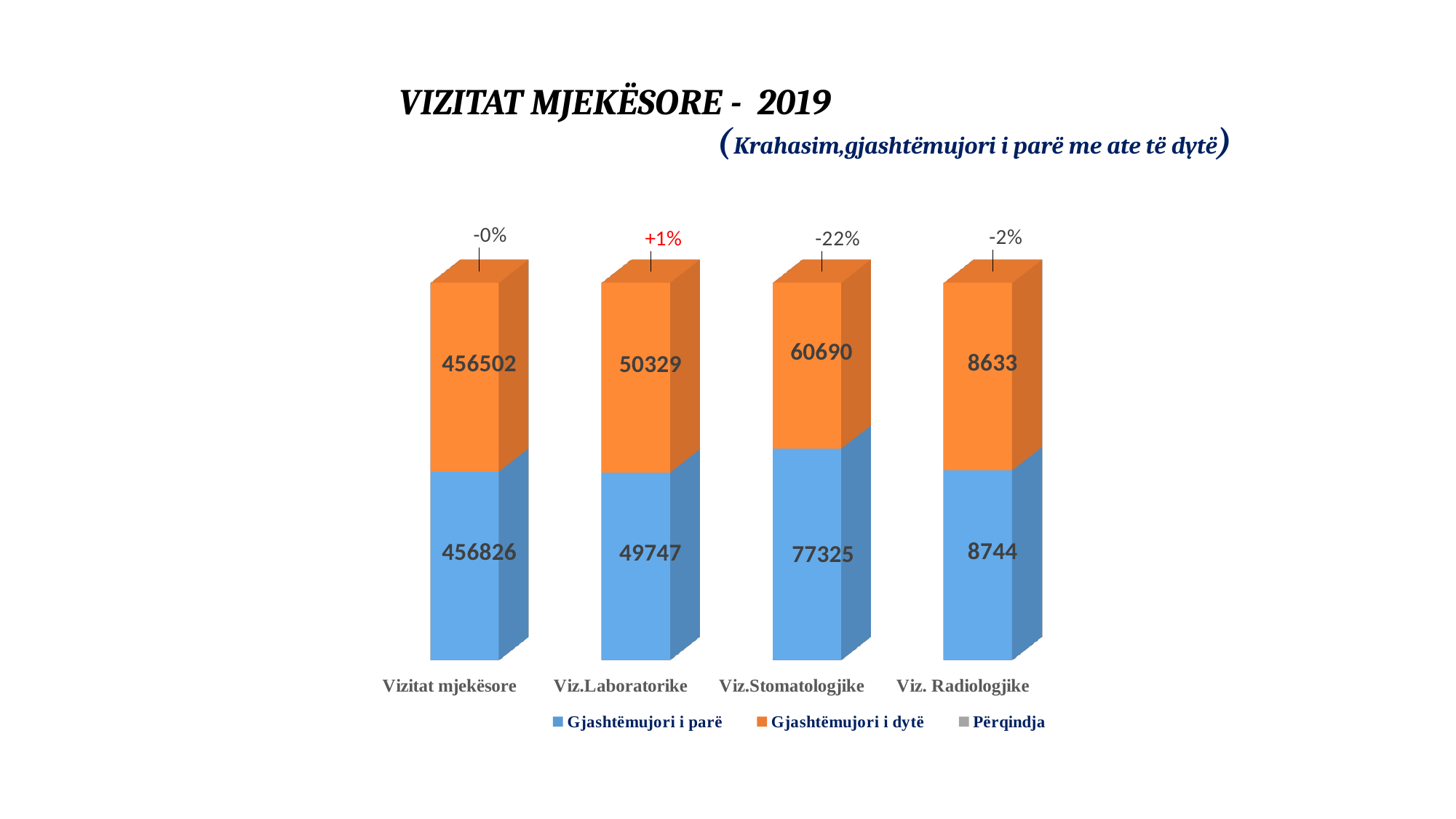
Which category has the highest value for Gjashtëmujori i parë? Vizitat mjekësore Which category has the lowest value for Gjashtëmujori i dytë? Viz. Radiologjike What is the value of Gjashtëmujori i parë for Viz.Stomatologjike? 77325 What is the difference between Gjashtëmujori i dytë and Gjashtëmujori i parë for Viz.Laboratorike? 582 What is the value of Gjashtëmujori i dytë for Viz. Radiologjike? 8633 How many categories are shown on the x axis? 4 How many series does the legend list? 3 What is the difference between Gjashtëmujori i parë and Gjashtëmujori i dytë for Viz.Stomatologjike? 16635 What kind of chart is shown on the slide? Stacked bar chart What is the value of Gjashtëmujori i dytë for Vizitat mjekësore? 456502 For Viz.Laboratorike, which is larger: Gjashtëmujori i parë or Gjashtëmujori i dytë? Gjashtëmujori i dytë What percentage label is shown above the Viz.Stomatologjike bar? -22%